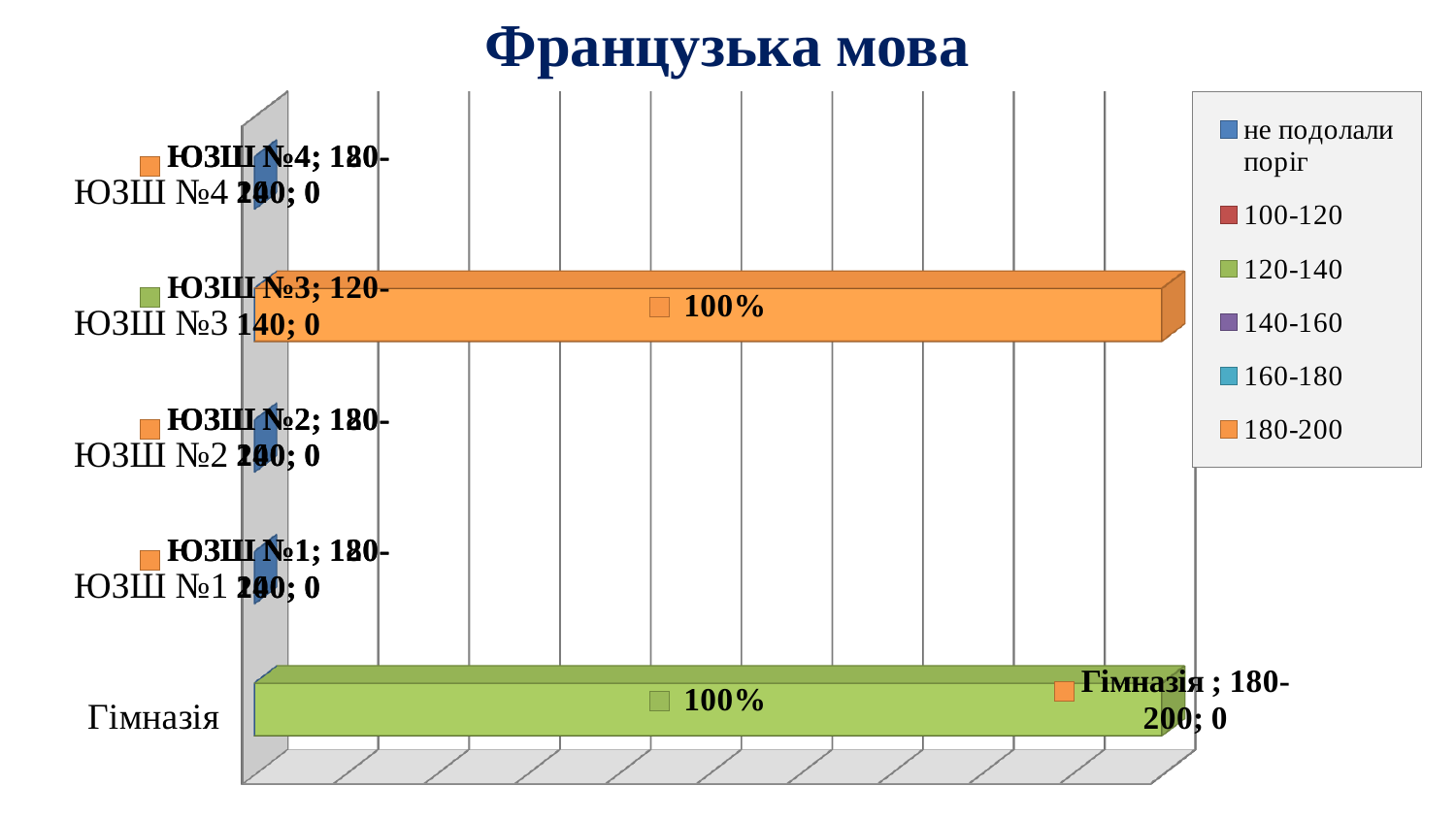
Which category is listed at the bottom of the vertical axis? Гімназія Which category has a 100% bar in the 180-200 series? ЮЗШ №3 Which colour represents the 180-200 series in the legend? orange What is the value of the 120-140 series for Гімназія? 100% Is the value of the 180-200 series for ЮЗШ №3 larger or smaller than the value of the 120-140 series for Гімназія? equal How many categories are shown on the vertical axis? 5 What is the title of the chart? Французька мова What kind of chart is shown on the slide? bar chart Which series has a value of 100% for Гімназія? 120-140 How many series does the legend list? 6 What is the value of the 180-200 series for ЮЗШ №3? 100%